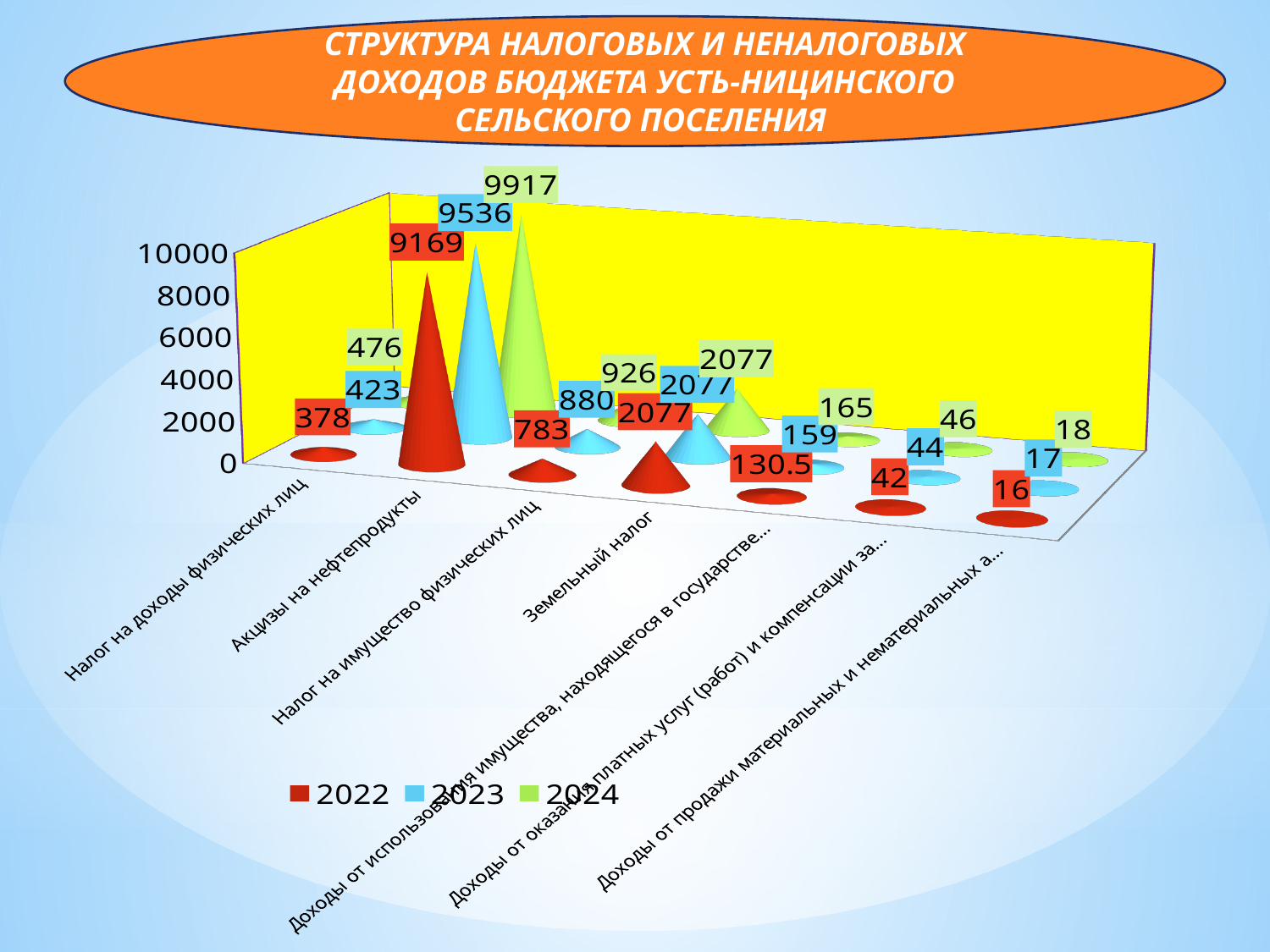
How many categories are shown on the x axis? 7 What is the value for Земельный налог in 2023? 2077 What kind of chart is shown on the slide? 3D bar chart (cone-shaped bars) Which is larger for Налог на имущество физических лиц: the 2022 value or the 2023 value? 2023 What is the value for Налог на доходы физических лиц in 2022? 378 Which category has the highest value in 2023? Акцизы на нефтепродукты What is the difference between the 2024 and 2022 values for Акцизы на нефтепродукты? 748 What is the value for Акцизы на нефтепродукты in 2024? 9917 Which category has the lowest value in 2024? Доходы от продажи материальных и нематериальных а... How many series does the legend list? 3 Do the values for Налог на доходы физических лиц rise or fall from 2022 to 2024? rise What is the 2022 value for Доходы от использования имущества, находящегося в государстве...? 130.5